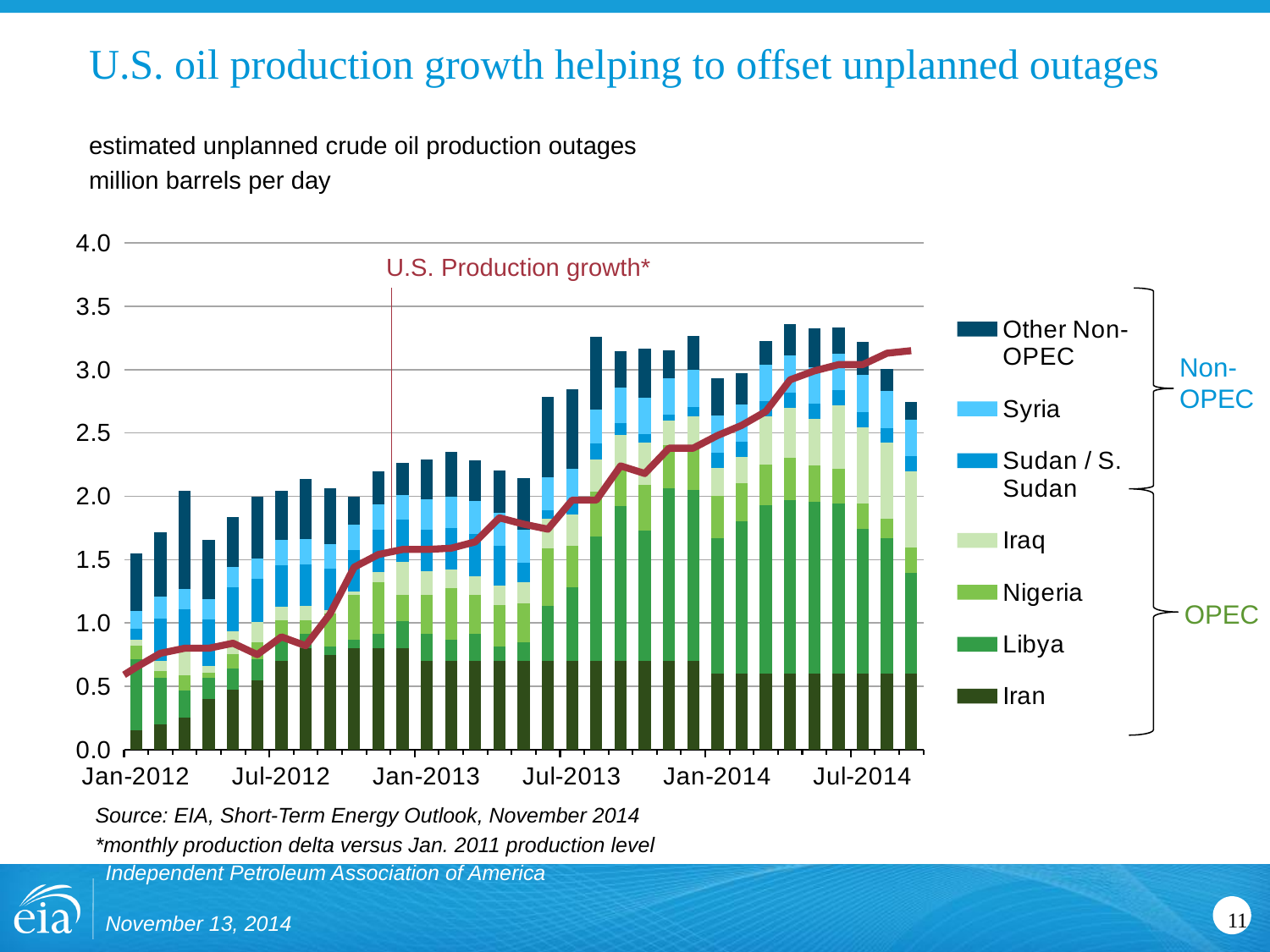
Is the total unplanned outage bar for Jan-2012 greater or less than 2.0? less Do the total unplanned outage bars generally rise or fall from Jan-2012 to Jan-2014? rise Is the total unplanned outage bar for Jan-2014 greater or less than 3.0? less Is the total unplanned outage bar for Jul-2013 greater or less than 3.0? less Which series is shown at the bottom of each stacked bar? Iran How many series does the legend list for the outages chart? 7 What unit is used on the y axis of the chart? million barrels per day What kind of chart is used to show the estimated unplanned crude oil production outages? Stacked bar chart with a line overlay Does the U.S. Production growth line generally rise or fall from Jan-2012 to Jul-2014? rise Which of the two is larger: the total outage bar for Jan-2012 or the total outage bar for Jul-2014? Jul-2014